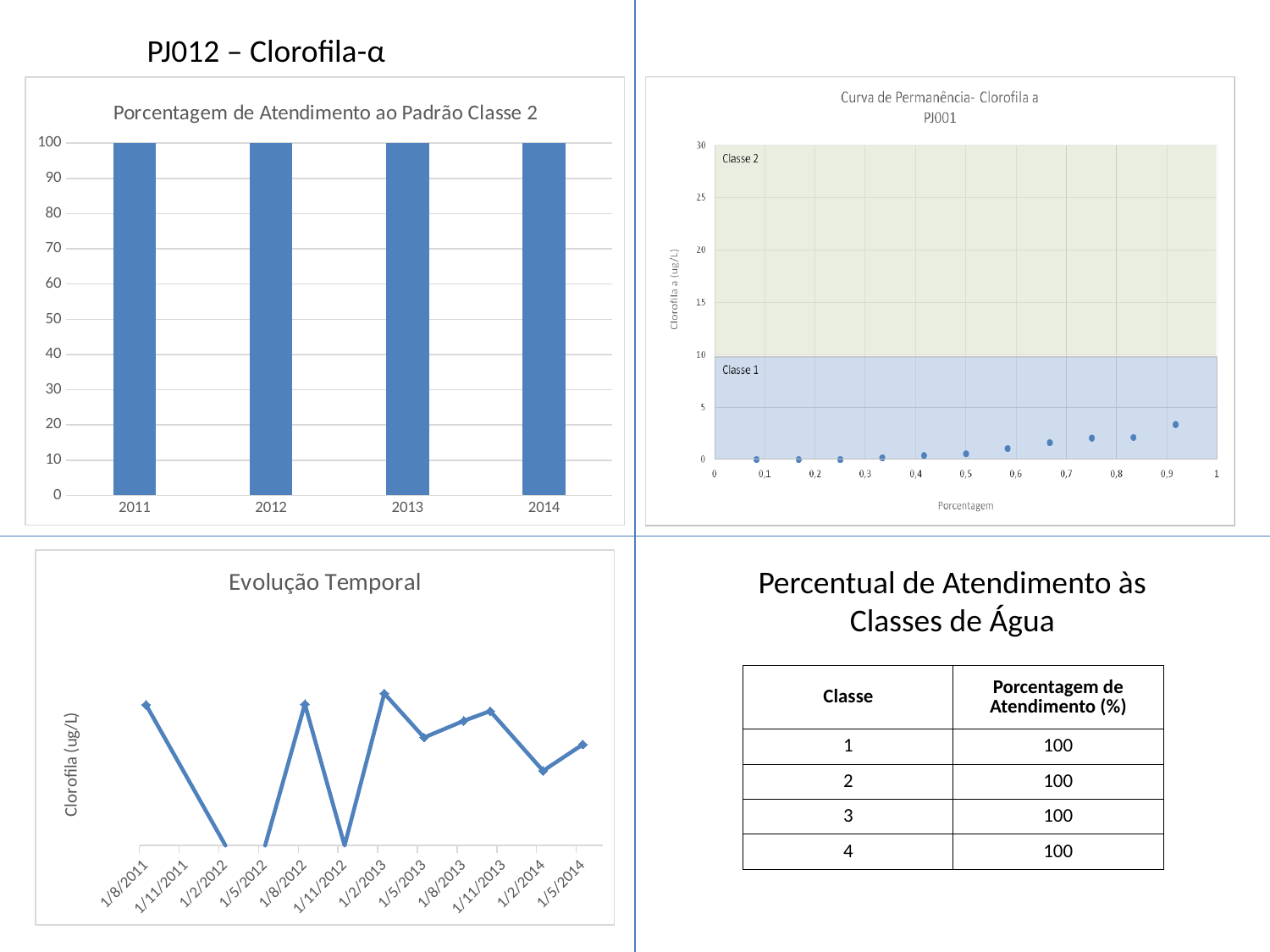
In the chart titled 'Porcentagem de Atendimento ao Padrão Classe 2', what is the value for 2011? 100 How many categories are shown on the x axis of the chart titled 'Porcentagem de Atendimento ao Padrão Classe 2'? 4 What is the y-axis title of the chart titled 'Curva de Permanência - Clorofila a PJ001'? Clorofila a (ug/L) In the chart titled 'Evolução Temporal', does the line rise or fall between 1/8/2011 and 1/2/2012? fall What kind of chart is the one titled 'Evolução Temporal'? line chart In the chart titled 'Curva de Permanência - Clorofila a PJ001', do the plotted values rise or fall as the x axis value increases? rise In the chart titled 'Curva de Permanência - Clorofila a PJ001', is the value of the point at 0,9 on the x axis greater or less than 5? less In the chart titled 'Porcentagem de Atendimento ao Padrão Classe 2', what is the difference between the values for 2012 and 2013? 0 In the chart titled 'Curva de Permanência - Clorofila a PJ001', is the value of the point at 0,5 on the x axis greater or less than 5? less In the chart titled 'Porcentagem de Atendimento ao Padrão Classe 2', what is the value for 2014? 100 What kind of chart is the one titled 'Porcentagem de Atendimento ao Padrão Classe 2'? bar chart In the chart titled 'Evolução Temporal', which is larger, the value at 1/2/2013 or the value at 1/2/2014? 1/2/2013